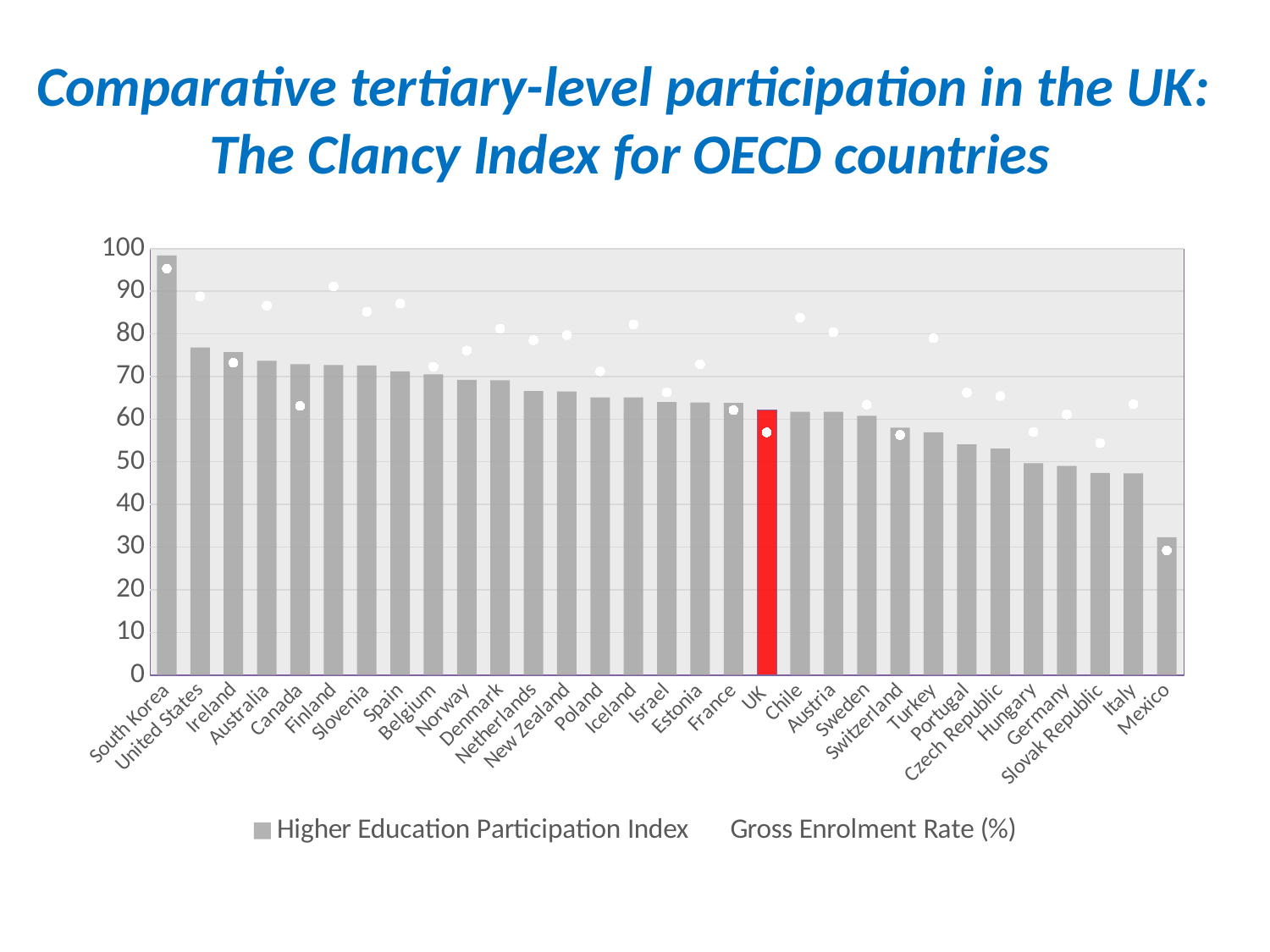
What kind of chart is used for the Higher Education Participation Index? Bar chart Which country has the highest Higher Education Participation Index? South Korea How many countries are shown on the x axis? 31 Which has the larger Higher Education Participation Index, United States or Italy? United States Is the Higher Education Participation Index for the UK greater or less than 50? greater How many series does the legend list? 2 Do the Higher Education Participation Index bars rise or fall from left to right? Fall Is the Higher Education Participation Index for South Korea greater or less than 90? greater Which country's bar is highlighted in red? UK Is the Higher Education Participation Index for Mexico greater or less than 40? less Which country has the lowest Higher Education Participation Index? Mexico